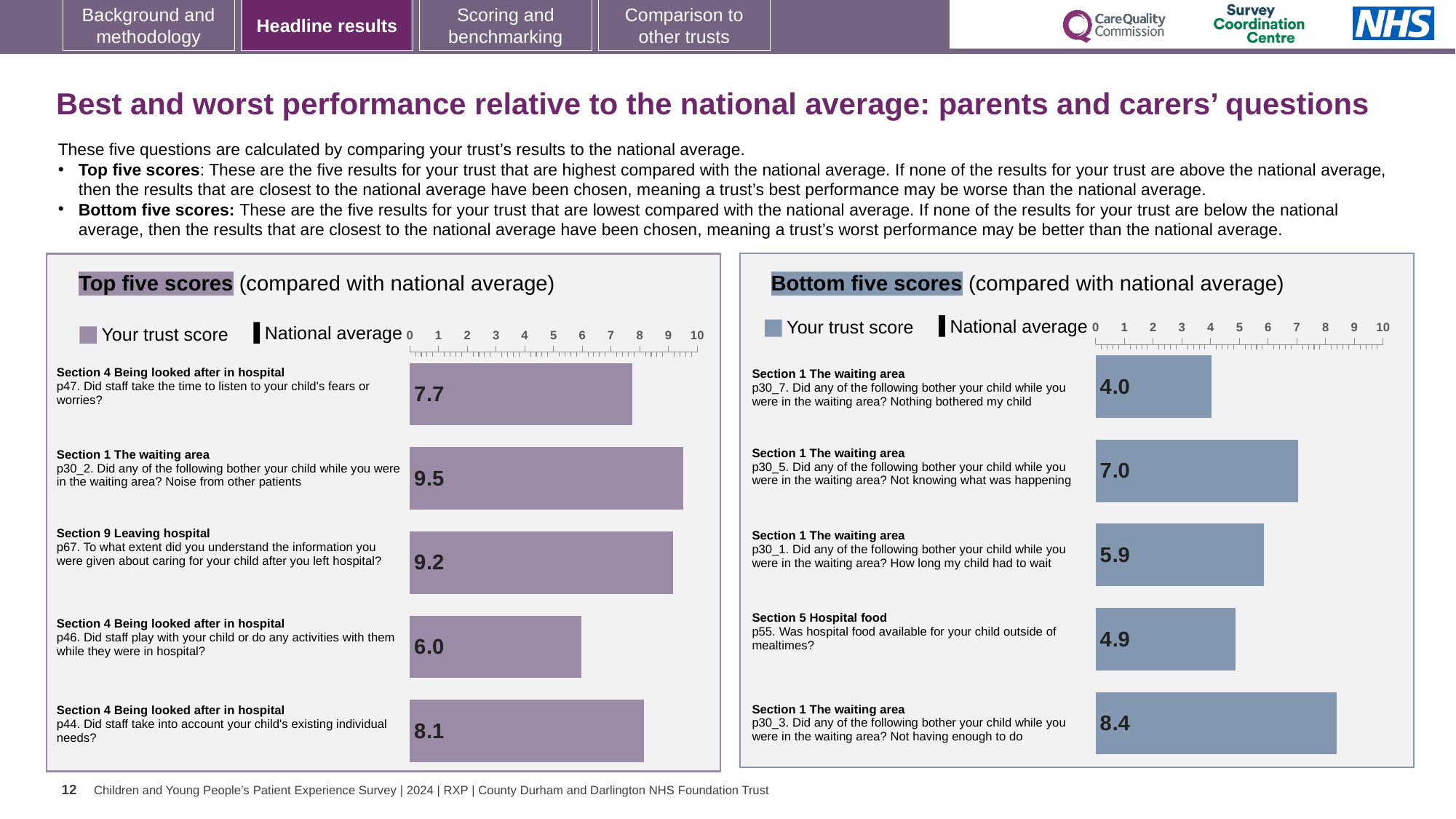
In the Top five scores chart, what is the trust score for p30_2 (Noise from other patients)? 9.5 In the Bottom five scores chart, what is the difference between the trust scores for p30_5 and p30_1? 1.1 How many bars are plotted in the Top five scores chart? 5 In the Bottom five scores chart, which has the larger trust score: p30_7 or p55? p55 In the Bottom five scores chart, what is the trust score for p55 (Was hospital food available for your child outside of mealtimes)? 4.9 What type of chart is the Bottom five scores chart? Bar chart In the Top five scores chart, what is the trust score for p46 (Did staff play with your child or do any activities with them while they were in hospital)? 6.0 In the Bottom five scores chart, which question has the lowest trust score? p30_7. Did any of the following bother your child while you were in the waiting area? Nothing bothered my child In the Top five scores chart, which question has the highest trust score? p30_2. Did any of the following bother your child while you were in the waiting area? Noise from other patients How many entries does the legend of the Top five scores chart list? 2 In the Top five scores chart, what is the difference between the trust scores for p67 and p44? 1.1 In the Bottom five scores chart, what is the trust score for p30_3 (Not having enough to do)? 8.4